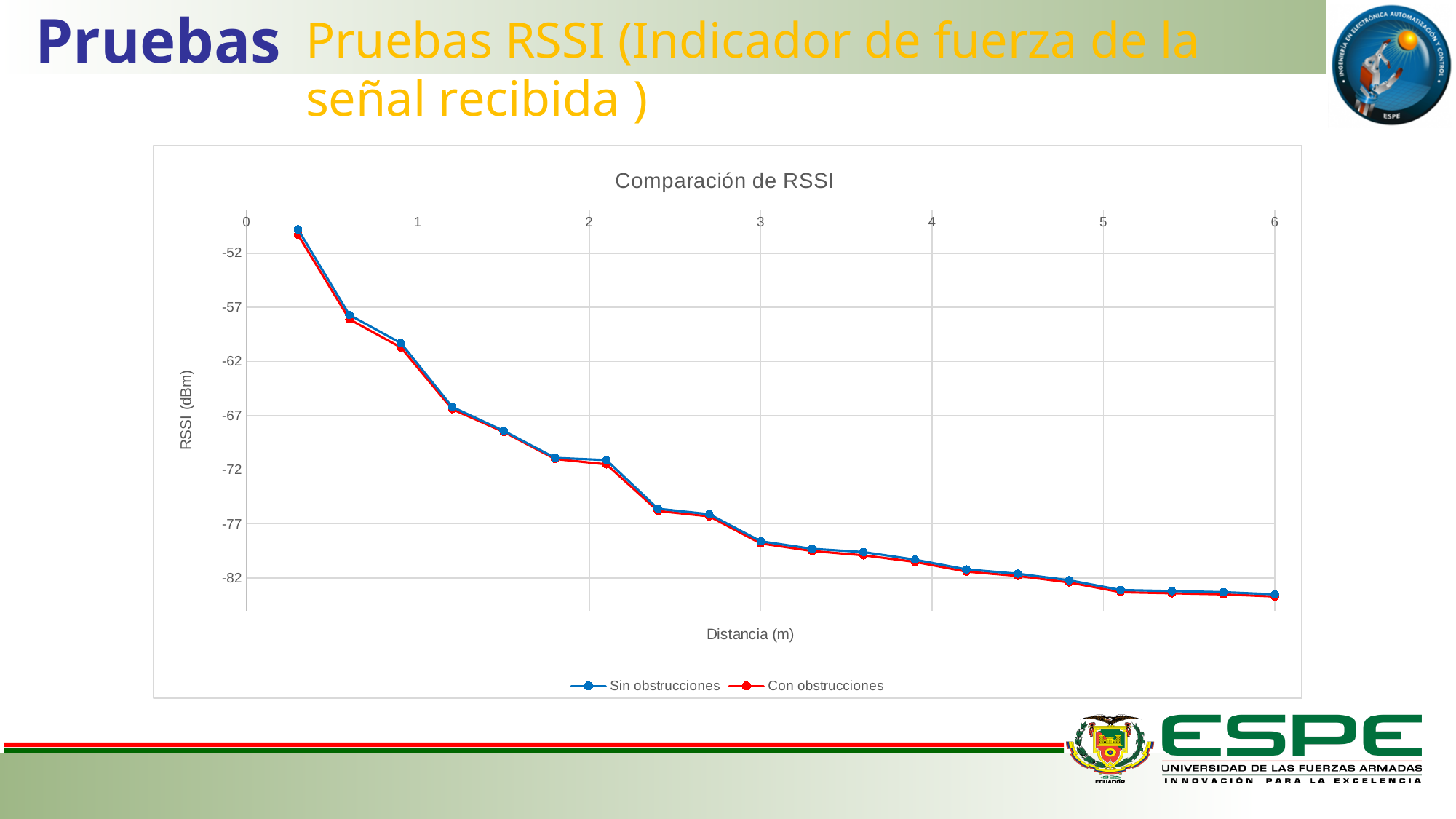
Is the RSSI value for Sin obstrucciones at a distance of 6 m greater or less than -82? less Which series is drawn in red in the chart? Con obstrucciones Is the RSSI value for Con obstrucciones at a distance of 4 m greater or less than -77? less Is the RSSI value for Con obstrucciones at a distance of 1.5 m greater or less than -67? less What is the title of the chart? Comparación de RSSI How many data points are plotted for the Sin obstrucciones series? 20 Do the RSSI values rise or fall as the distance increases along the x axis? fall What is the label of the y axis of the chart? RSSI (dBm) How many series does the legend of the chart list? 2 What kind of chart is shown on the slide? line chart